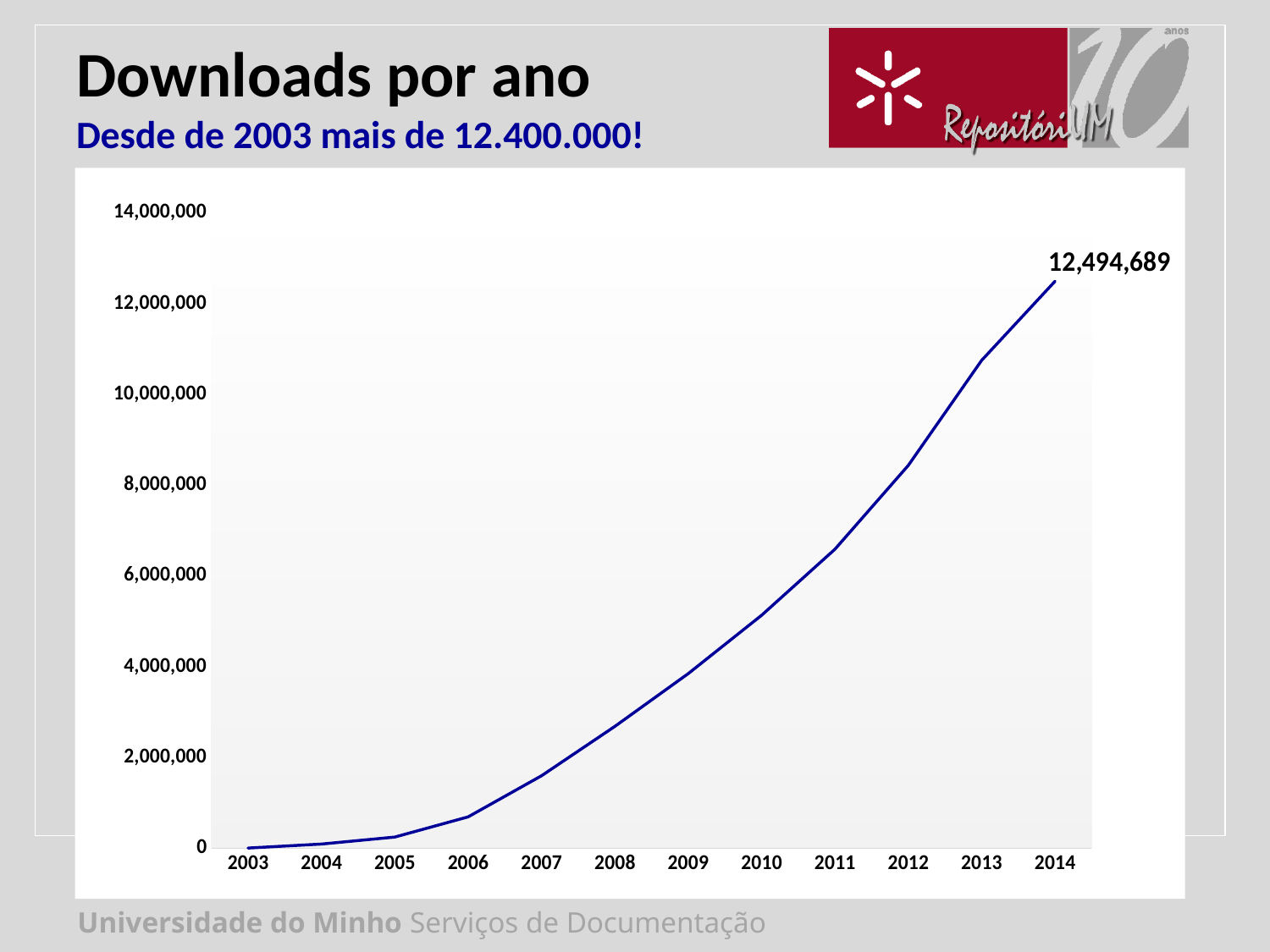
Is the value for 2008 greater or less than 4,000,000? less Is the value for 2006 greater or less than 2,000,000? less Is the value for 2013 greater or less than 10,000,000? greater What is the title of the chart on the slide? Downloads por ano Do the values rise or fall from 2003 to 2014? rise Which year has the lowest value on the chart? 2003 What kind of chart is shown on the slide? line chart Which year has the highest value on the chart? 2014 How many years are plotted on the x axis? 12 Which year has the larger value, 2009 or 2012? 2012 What is the value shown for 2014? 12,494,689